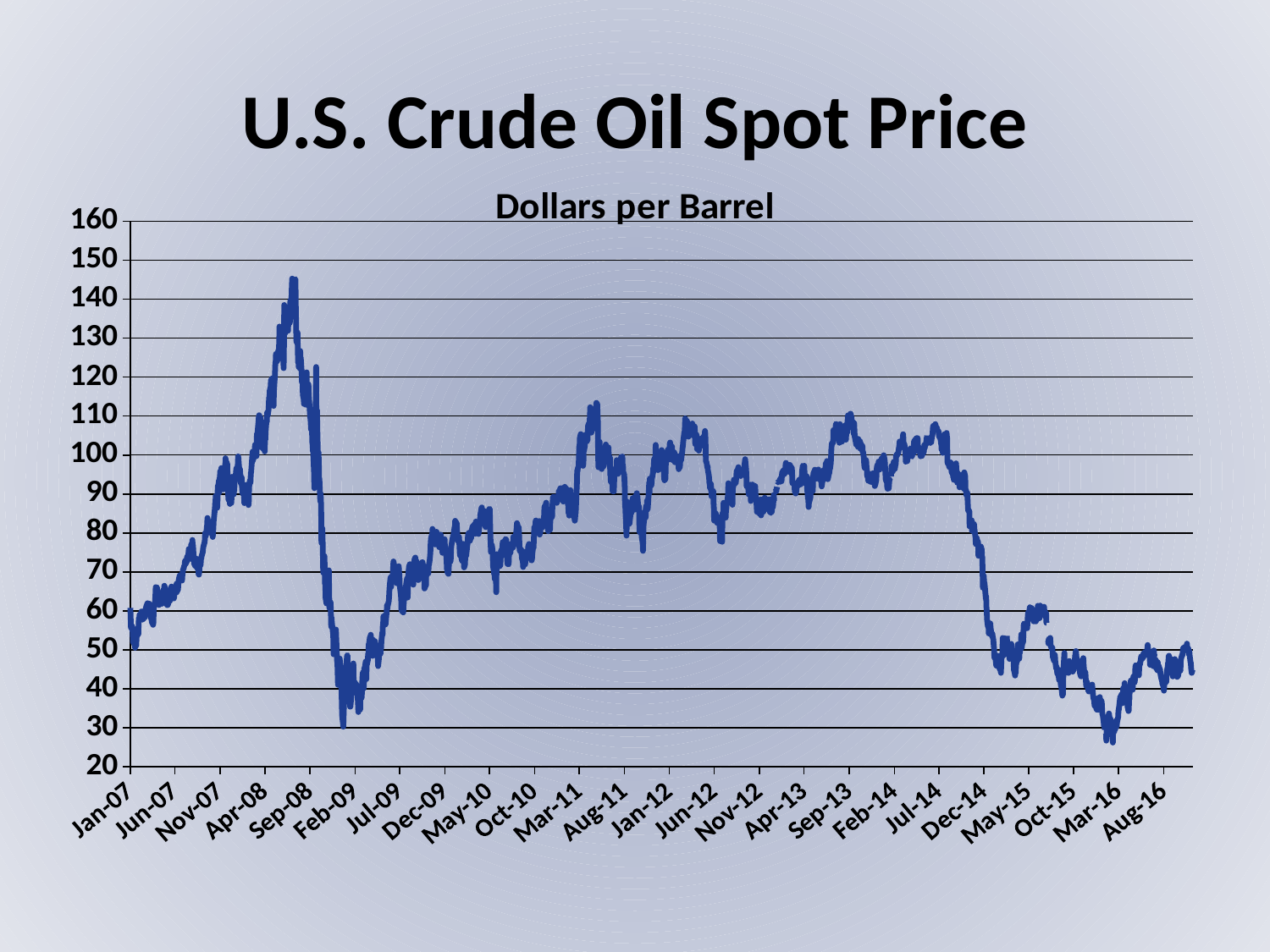
In what units are the values on the chart expressed? Dollars per Barrel Is the value around Aug-16 greater or less than 60? less Is the value around Jul-14 greater or less than 90? greater Is the lowest value reached in early 2009 greater or less than 40? less Does the price rise or fall between Jul-14 and Dec-14? fall How many data series are plotted on the chart? 1 What kind of chart is shown on the slide? Line chart What is the title of the chart? U.S. Crude Oil Spot Price Does the price rise or fall between Feb-09 and Mar-11? rise